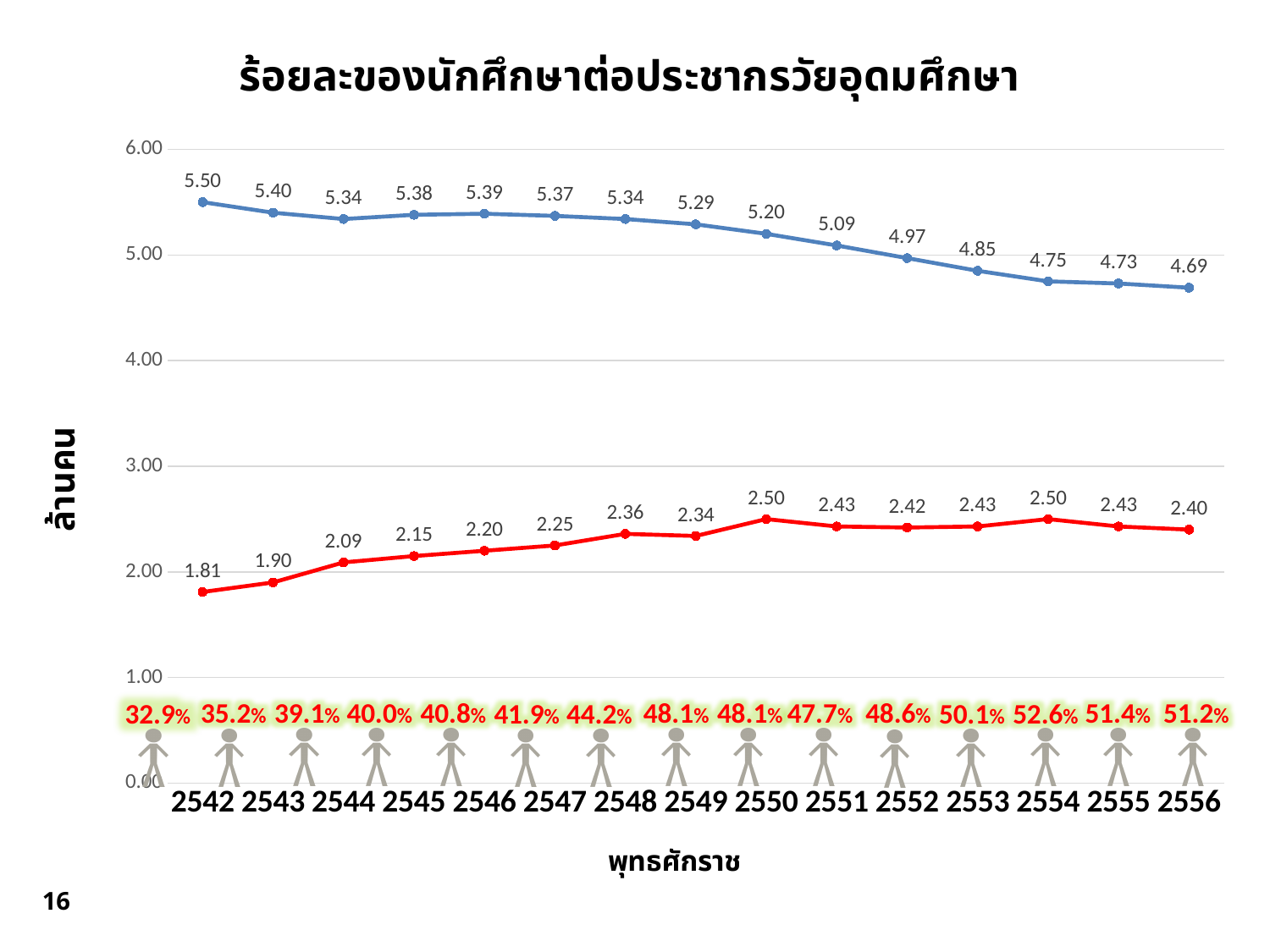
Which is larger in the year 2548: the blue line value or the red line value? the blue line value What kind of chart is shown on the slide? line chart In which year does the red line have its lowest value? 2542 What is the difference between the blue line value and the red line value in the year 2542? 3.69 In which year does the blue line reach its lowest value? 2556 What is the value of the blue line for the year 2556? 4.69 What is the label on the y axis of the chart? ล้านคน What is the value of the red line for the year 2550? 2.50 What percentage is shown below the chart for the year 2554? 52.6% Does the blue line generally rise or fall from 2542 to 2556? fall What is the value of the blue line for the year 2542? 5.50 How many years are shown on the x axis? 15